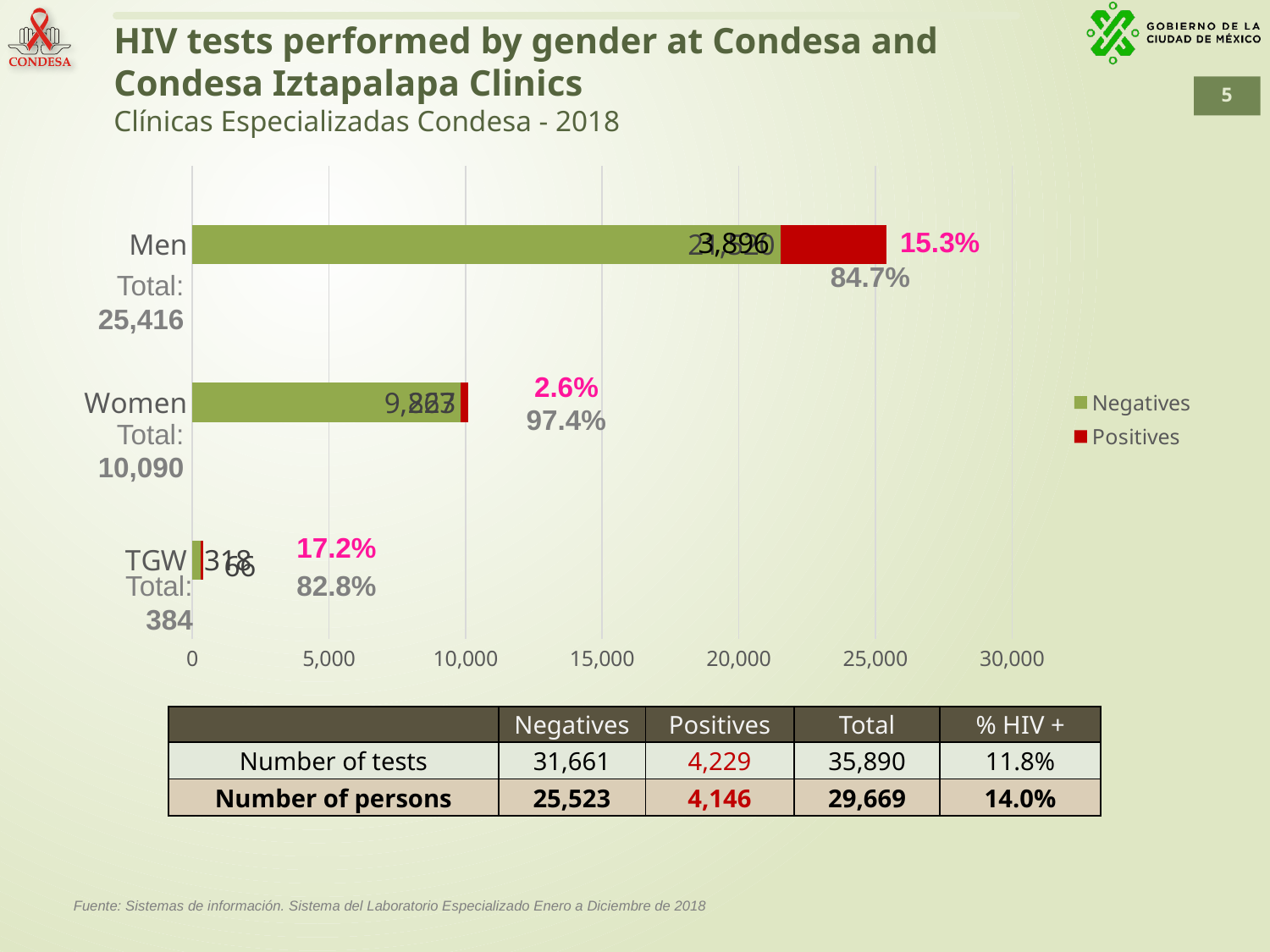
What kind of chart is shown on the slide? bar chart What is the total number of HIV tests shown for Men? 25,416 What percentage of tests among Men were positive? 15.3% Which gender category has the highest total number of tests? Men What is the total number of HIV tests shown for Women? 10,090 What is the total number of HIV tests shown for TGW? 384 What percentage of tests among Women were negative? 97.4% What percentage of tests among TGW were positive? 17.2% How many series does the chart legend list? 2 Which gender category has the lowest total number of tests? TGW Is the Negatives value for Men greater or less than 20,000? greater How many gender categories are plotted in the chart? 3